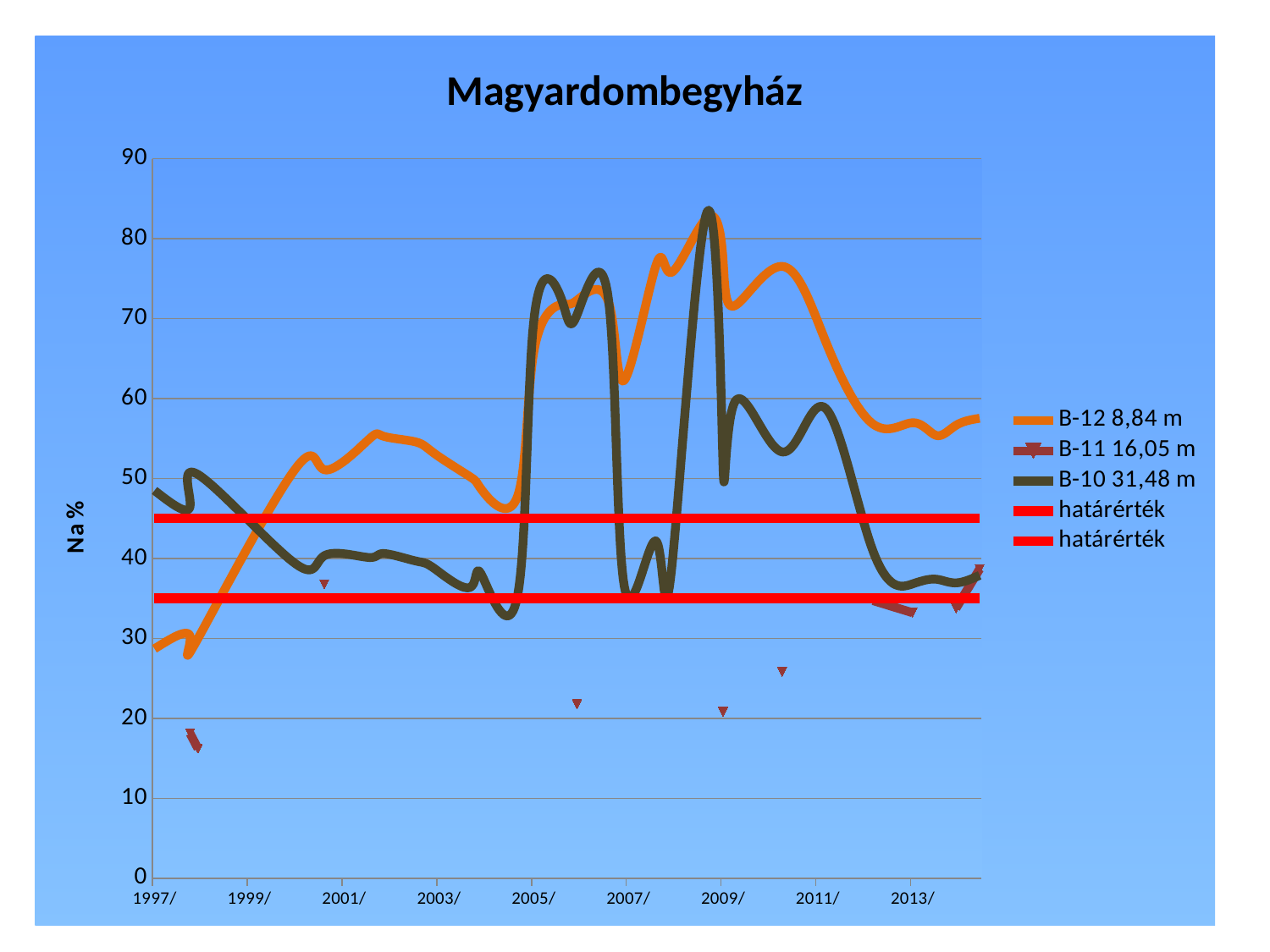
Is the value for B-12 8,84 m at 1997/ greater or less than 40? less How many entries does the legend list? 5 What is the title of the chart? Magyardombegyház Is the value for B-10 31,48 m at 2013/ greater or less than 45? less Is the highest value reached by B-10 31,48 m greater or less than 80? greater At 2009/, which series has the larger value, B-12 8,84 m or B-11 16,05 m? B-12 8,84 m What kind of chart is shown on the slide? line chart What is the label of the vertical axis? Na % How many year labels are shown on the horizontal axis? 9 Does the B-12 8,84 m line rise or fall between 1997/ and 1999/? rises